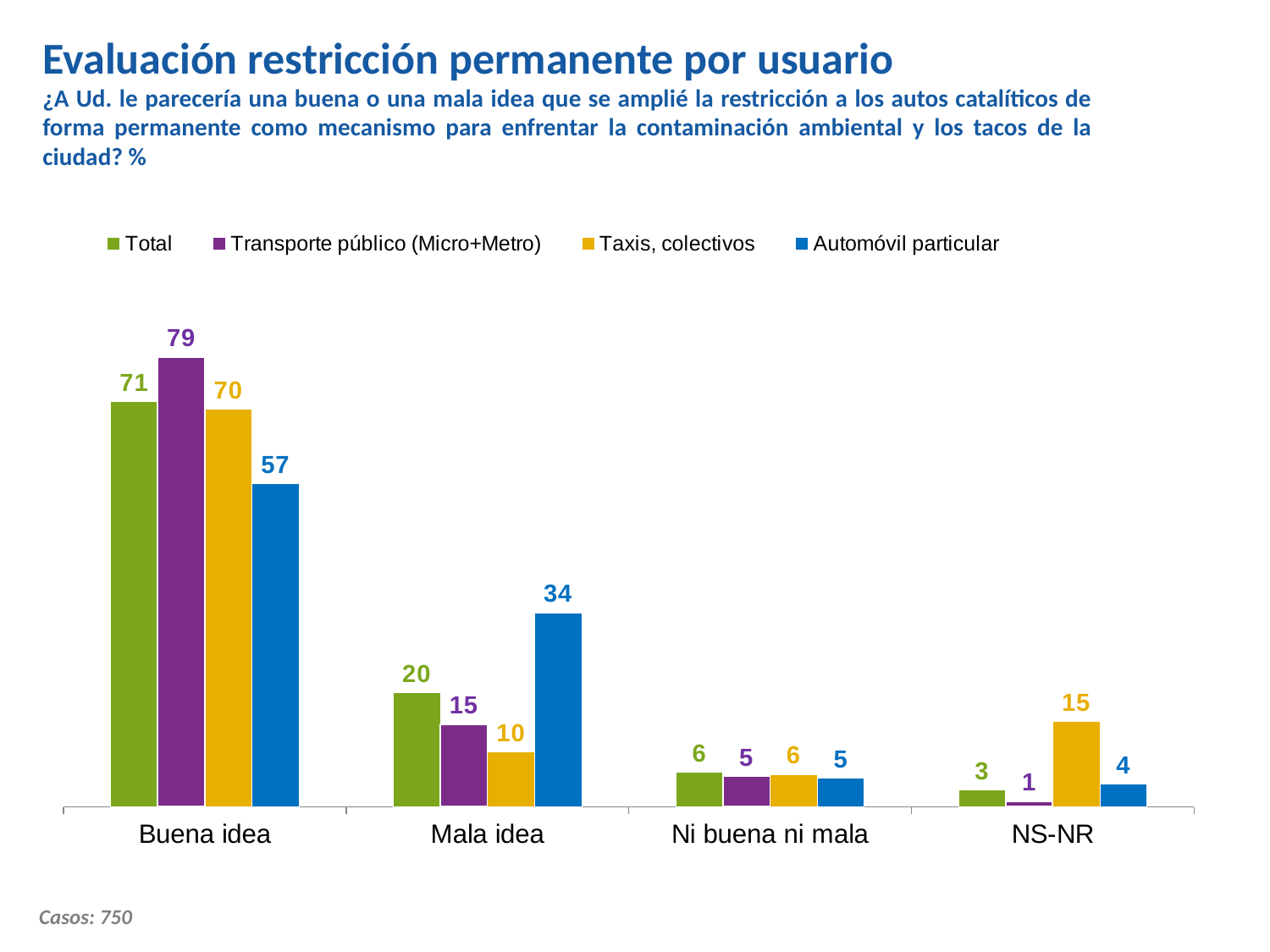
How many categories are shown on the x axis? 4 What is the value for Automóvil particular in the Mala idea category? 34 What is the number of cases (Casos) noted on the slide? 750 What is the Total value for Ni buena ni mala? 6 Which series has the highest value in the Buena idea category? Transporte público (Micro+Metro) How many series does the legend list? 4 What kind of chart is shown on the slide? Bar chart What is the difference between the Total value for Buena idea and the Total value for Mala idea? 51 What is the value for Transporte público (Micro+Metro) in the Buena idea category? 79 Which series has the lowest value in the NS-NR category? Transporte público (Micro+Metro) What is the value for Taxis, colectivos in the NS-NR category? 15 Which is larger in the Mala idea category: Total or Automóvil particular? Automóvil particular